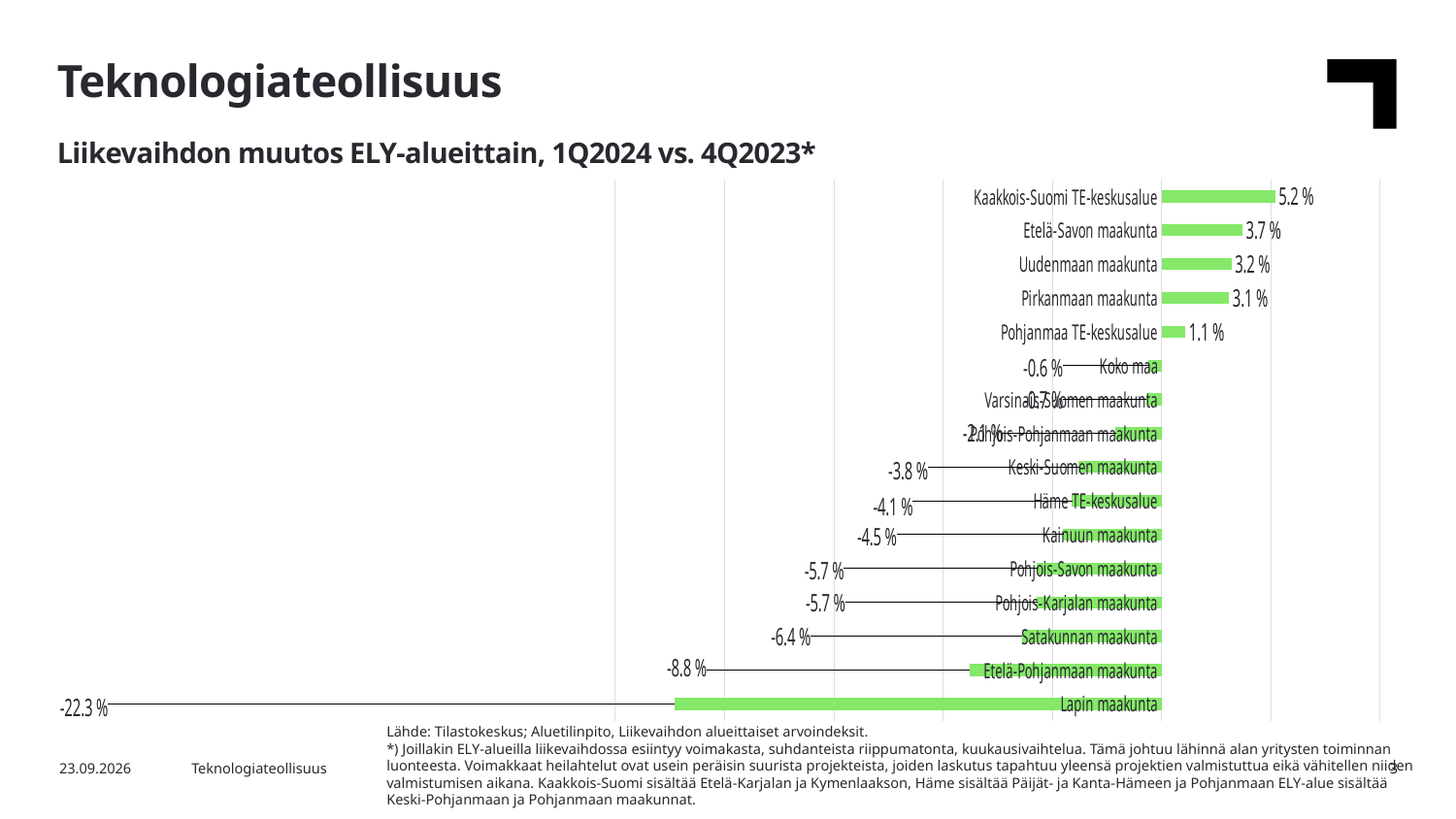
What is the title of the chart? Liikevaihdon muutos ELY-alueittain, 1Q2024 vs. 4Q2023* What is the difference between the values for Kaakkois-Suomi TE-keskusalue and Etelä-Savon maakunta? 1.5 % Which is larger, the value for Kainuun maakunta or Etelä-Pohjanmaan maakunta? Kainuun maakunta What kind of chart is shown on the slide? Bar chart What is the value for Koko maa? -0.6 % How many regions are shown in the chart? 16 What is the value for Kaakkois-Suomi TE-keskusalue? 5.2 % What is the value for Satakunnan maakunta? -6.4 % Which is larger, the value for Uudenmaan maakunta or Pirkanmaan maakunta? Uudenmaan maakunta Which region has the lowest value? Lapin maakunta What is the value for Lapin maakunta? -22.3 % Which region has the highest value? Kaakkois-Suomi TE-keskusalue